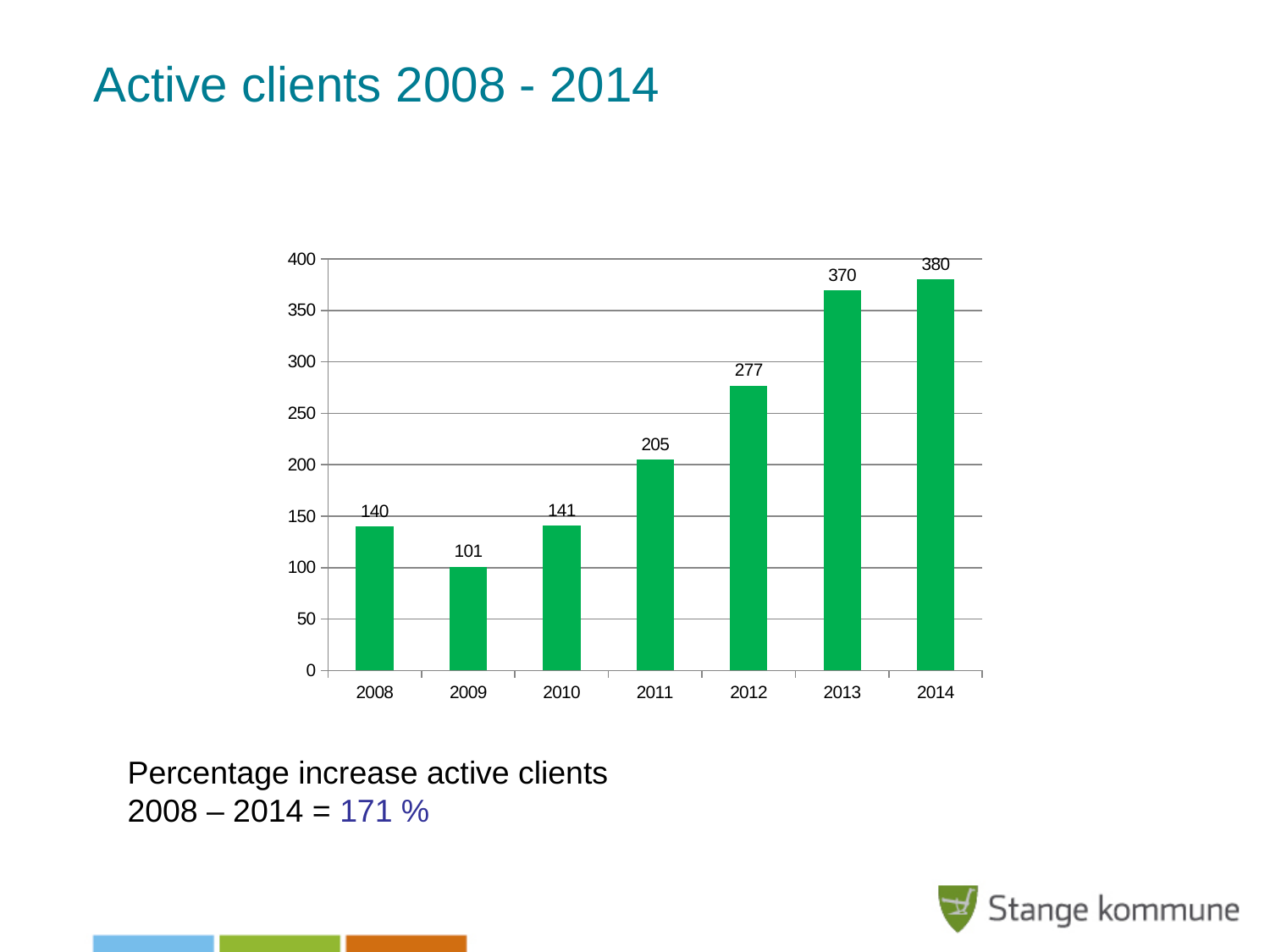
Is the value for 2013 greater or less than 350? greater What kind of chart is shown on the slide? Bar chart What is the number of active clients in 2012? 277 What is the number of active clients in 2009? 101 What is the difference between the values for 2013 and 2012? 93 Which is larger, the value for 2011 or the value for 2010? 2011 How many years are shown on the x axis? 7 Do the values generally rise or fall from 2009 to 2014? Rise Which year has the highest number of active clients? 2014 Which year has the lowest number of active clients? 2009 What is the title of the slide containing the chart? Active clients 2008 - 2014 What is the difference between the values for 2014 and 2008? 240